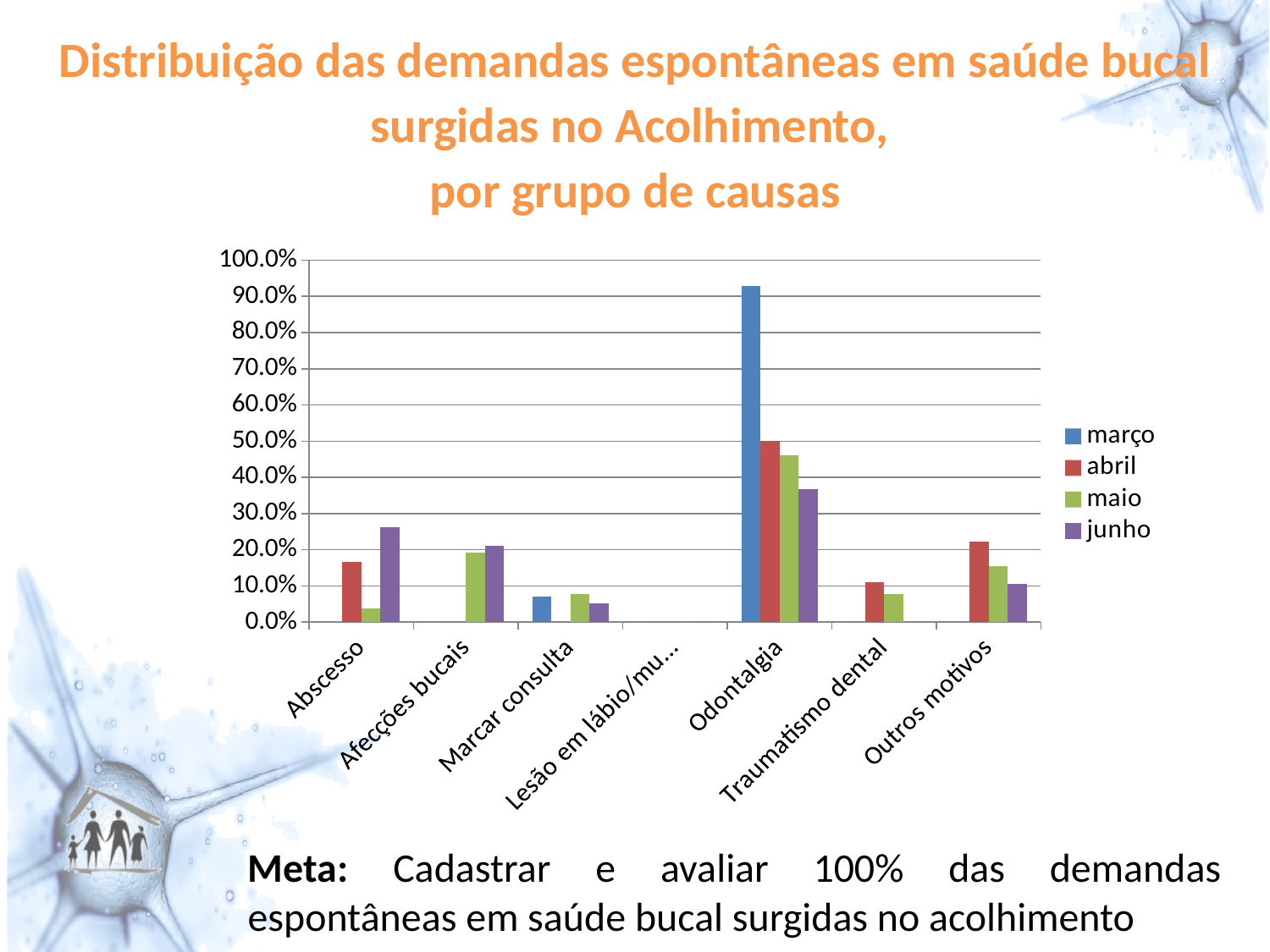
Is the junho value for Abscesso greater or less than 20.0%? greater How many series does the legend list? 4 Is the março value for Odontalgia greater or less than 90.0%? greater For Odontalgia, which month has the lowest bar? junho Is the abril value for Outros motivos greater or less than 30.0%? less For Abscesso, which is larger: the abril value or the junho value? junho How many cause groups (categories) are shown on the x axis? 7 What colour represents março in the legend? blue What kind of chart is shown on the slide? bar chart For Odontalgia, which is larger: the março value or the abril value? março Which category has the highest bar for março? Odontalgia